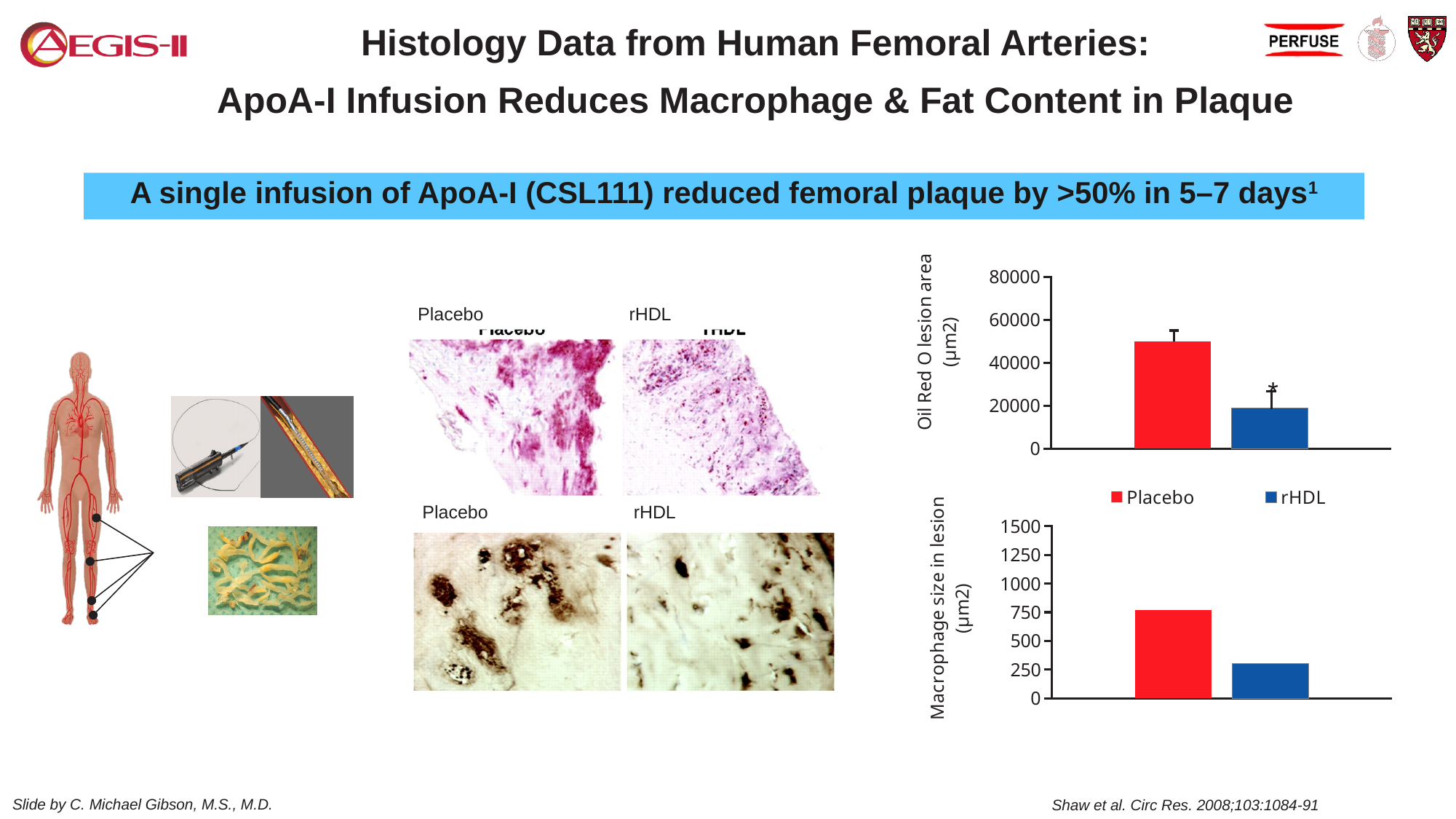
What colour is the rHDL bar in the charts? blue What is the y-axis label of the top chart on the right? Oil Red O lesion area (μm2) In the bottom chart (Macrophage size in lesion), which group has the lower value? rHDL In the top chart (Oil Red O lesion area), is the value for rHDL greater or less than 40000? less What kind of chart is the bottom chart on the right (Macrophage size in lesion)? bar chart How many bars are plotted in the bottom chart (Macrophage size in lesion)? 2 In the top chart (Oil Red O lesion area), which group has the higher value, Placebo or rHDL? Placebo In the bottom chart (Macrophage size in lesion), is the value for rHDL greater or less than 500? less What kind of chart is the top chart on the right (Oil Red O lesion area)? bar chart In the top chart (Oil Red O lesion area), is the value for Placebo greater or less than 40000? greater How many series does the legend between the two charts list? 2